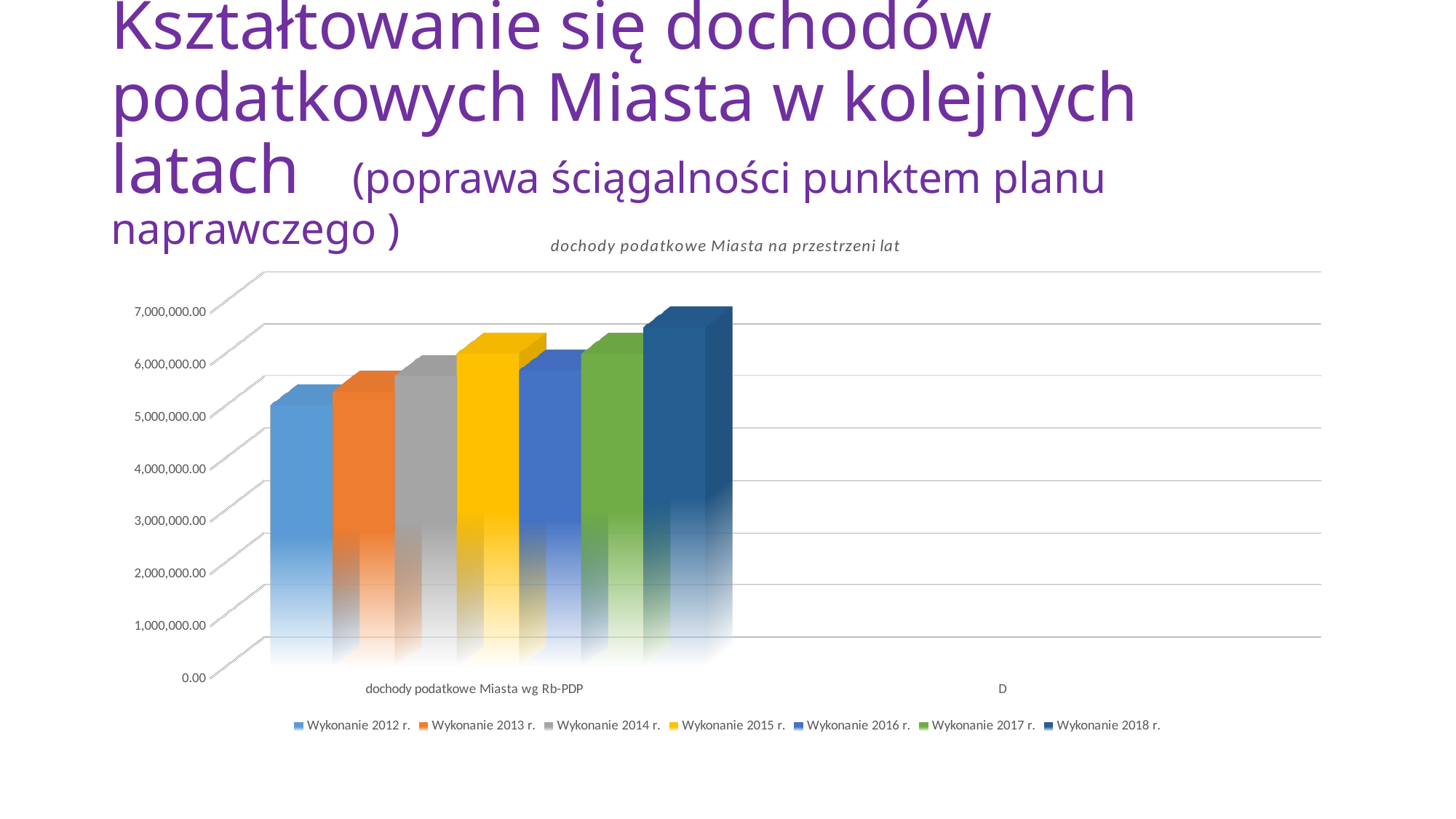
What is the title of the chart? dochody podatkowe Miasta na przestrzeni lat Is the value for Wykonanie 2012 r. greater or less than 6,000,000.00? less What kind of chart is shown on the slide? bar chart How many bars are plotted in the chart? 7 How many series does the chart legend list? 7 Which is larger, the bar for Wykonanie 2018 r. or the bar for Wykonanie 2016 r.? Wykonanie 2018 r. Which is larger, the bar for Wykonanie 2015 r. or the bar for Wykonanie 2014 r.? Wykonanie 2015 r. Which series has the highest bar in the chart? Wykonanie 2018 r. Which series has the lowest bar in the chart? Wykonanie 2012 r. What colour is the bar for Wykonanie 2015 r.? yellow Is the value for Wykonanie 2013 r. greater or less than 4,000,000.00? greater Is the value for Wykonanie 2018 r. greater or less than 6,000,000.00? greater